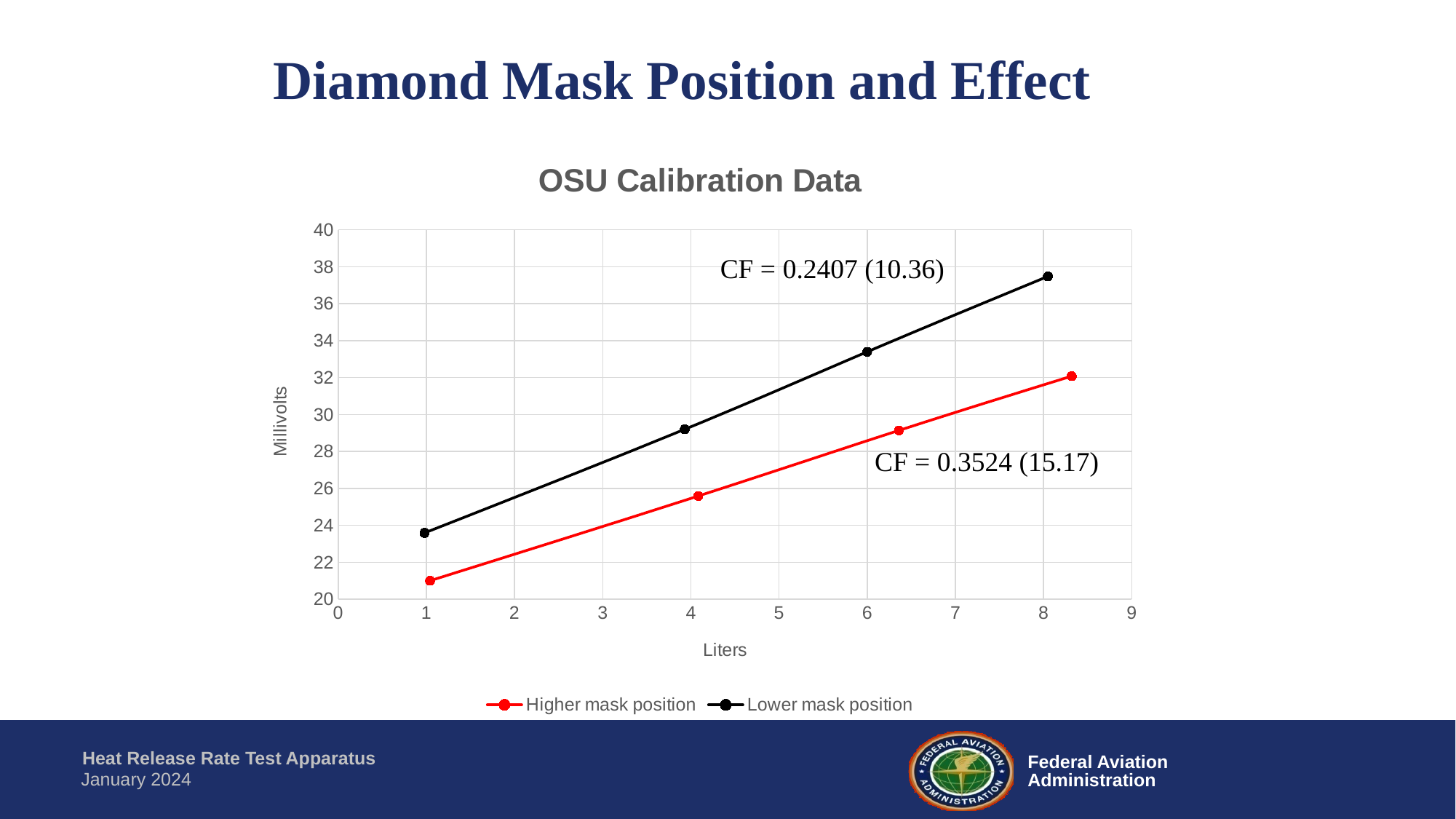
What kind of chart is shown on the slide? line chart What is the title of the chart? OSU Calibration Data Is the Millivolts value for the Higher mask position at about 8 liters greater or less than 30? greater Is the Millivolts value for the Lower mask position at about 1 liter greater or less than 22? greater How many data points are plotted for the Lower mask position series? 4 Which series reaches the highest Millivolts value on the chart? Lower mask position Do the Millivolts values for the Higher mask position series rise or fall as Liters increase? rise Which series has the higher Millivolts value at about 8 liters, Higher mask position or Lower mask position? Lower mask position How many series does the legend list? 2 Is the Millivolts value for the Lower mask position at about 8 liters greater or less than 36? greater What is the label of the y axis? Millivolts